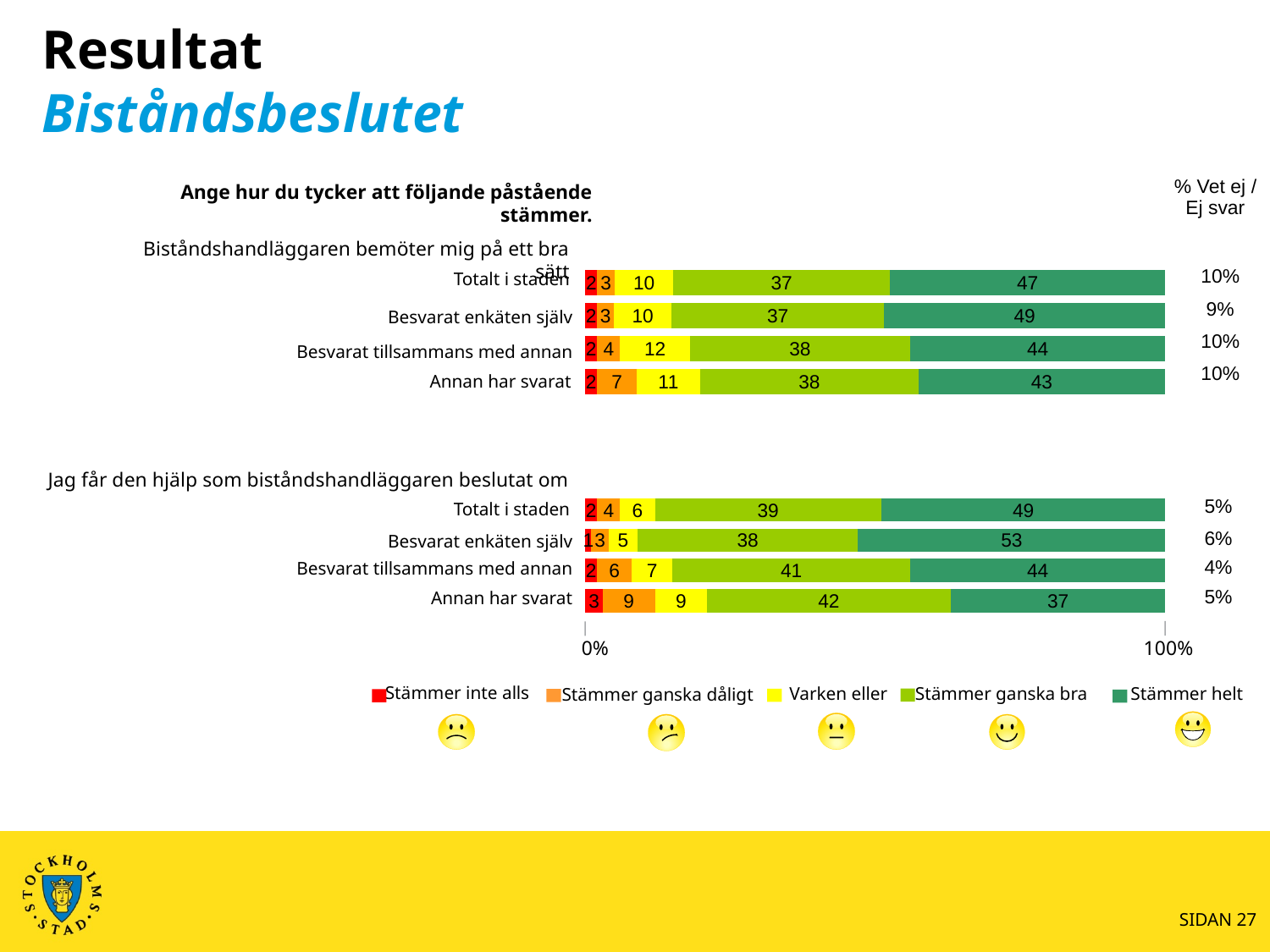
How many categories (bars) are shown in the chart for "Jag får den hjälp som biståndshandläggaren beslutat om"? 4 What is the "% Vet ej / Ej svar" value shown for "Totalt i staden" in the chart for "Jag får den hjälp som biståndshandläggaren beslutat om"? 5% In the chart for "Jag får den hjälp som biståndshandläggaren beslutat om", what is the difference between the "Stämmer helt" values for "Besvarat enkäten själv" and "Annan har svarat"? 16 In the chart for "Jag får den hjälp som biståndshandläggaren beslutat om", which category has the highest value for "Stämmer helt"? Besvarat enkäten själv In the chart for "Biståndshandläggaren bemöter mig på ett bra sätt", which category has the lowest value for "Stämmer helt"? Annan har svarat In the chart for "Biståndshandläggaren bemöter mig på ett bra sätt", is the "Stämmer helt" value larger for "Besvarat enkäten själv" or for "Besvarat tillsammans med annan"? Besvarat enkäten själv What kind of chart is used on the slide? Stacked bar chart In the chart for "Jag får den hjälp som biståndshandläggaren beslutat om", what is the value of "Stämmer ganska bra" for "Besvarat tillsammans med annan"? 41 In the chart for "Biståndshandläggaren bemöter mig på ett bra sätt", what is the value of "Varken eller" for "Besvarat tillsammans med annan"? 12 How many series does the legend list? 5 In the chart for "Biståndshandläggaren bemöter mig på ett bra sätt", what is the value of "Stämmer helt" for "Totalt i staden"? 47 In the chart for "Jag får den hjälp som biståndshandläggaren beslutat om", what is the value of "Stämmer helt" for "Annan har svarat"? 37